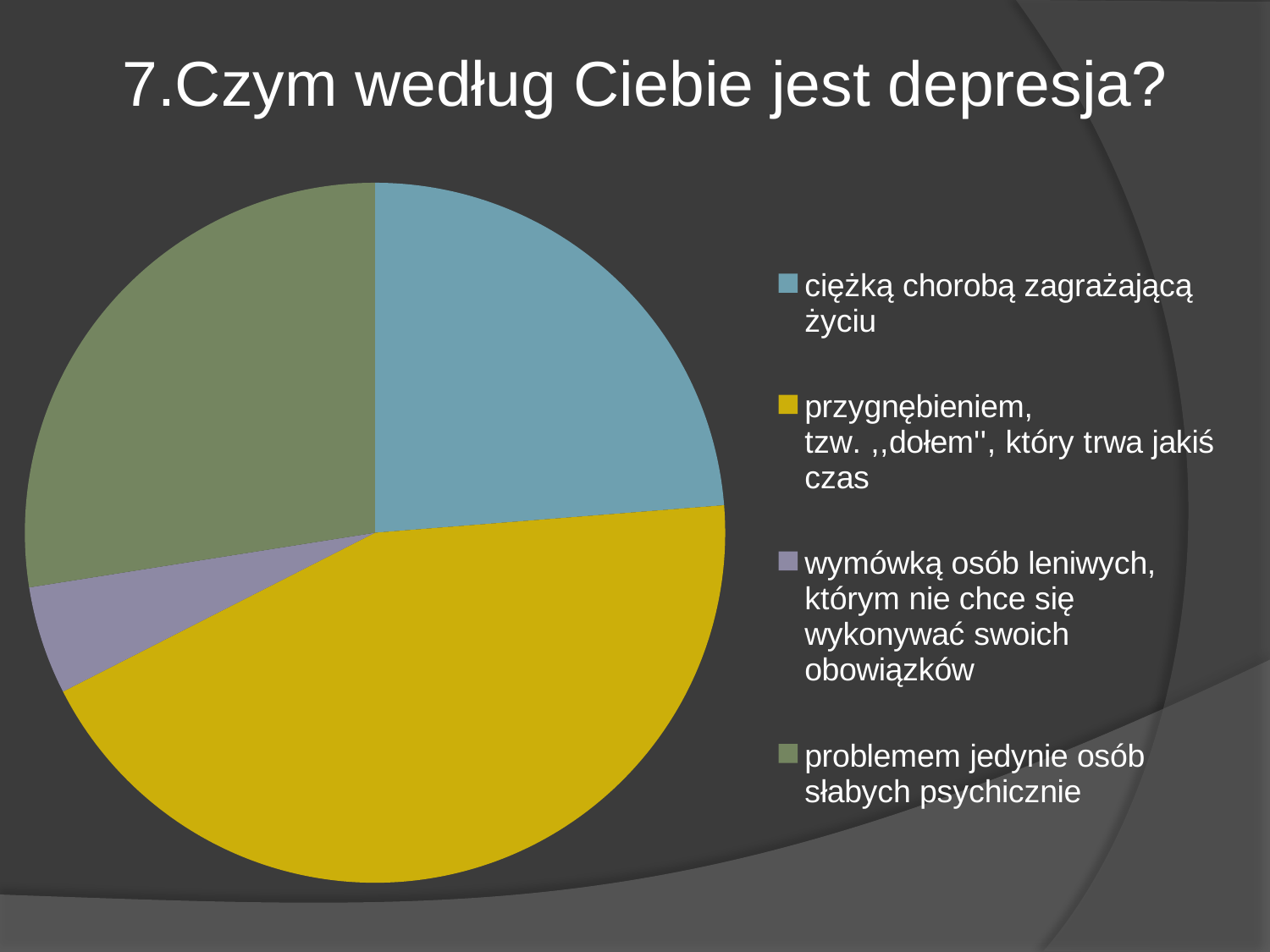
Which category has the largest slice of the pie chart? przygnębieniem, tzw. ,,dołem'', który trwa jakiś czas Which slice is larger: "ciężką chorobą zagrażającą życiu" or "przygnębieniem, tzw. ,,dołem'', który trwa jakiś czas"? przygnębieniem, tzw. ,,dołem'', który trwa jakiś czas How many slices does the pie chart have? 4 Which slice is larger: "wymówką osób leniwych, którym nie chce się wykonywać swoich obowiązków" or "problemem jedynie osób słabych psychicznie"? problemem jedynie osób słabych psychicznie What colour is the slice for "problemem jedynie osób słabych psychicznie"? green Which category has the smallest slice of the pie chart? wymówką osób leniwych, którym nie chce się wykonywać swoich obowiązków Which slice is larger: "problemem jedynie osób słabych psychicznie" or "przygnębieniem, tzw. ,,dołem'', który trwa jakiś czas"? przygnębieniem, tzw. ,,dołem'', który trwa jakiś czas How many entries does the legend of the pie chart list? 4 What kind of chart is shown on the slide? pie chart What is the title of the slide containing the pie chart? 7.Czym według Ciebie jest depresja?